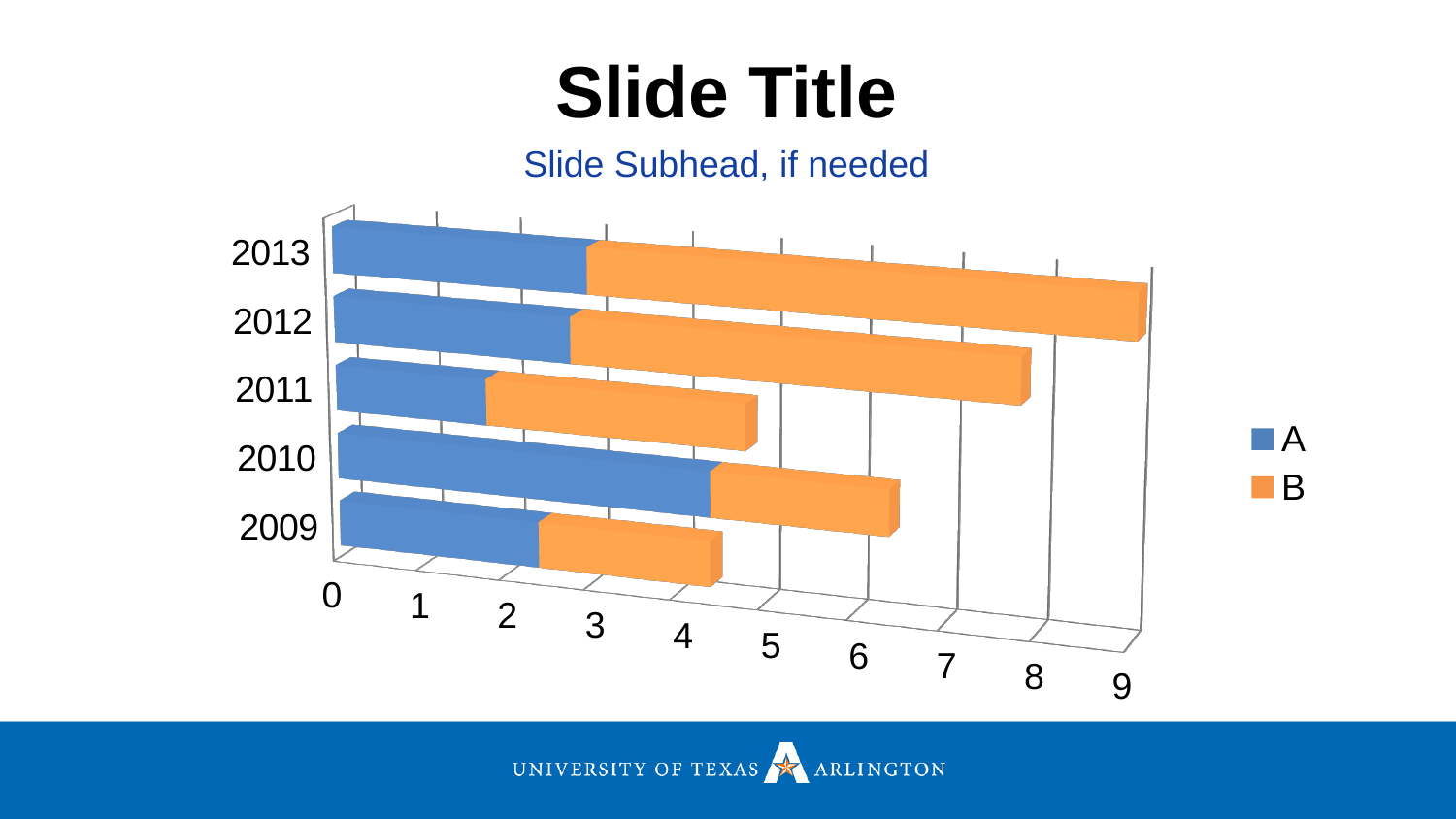
Is the total stacked bar for 2009 greater or less than 6? less How many series does the legend list? 2 Which colour represents series B? Orange Which year has the larger value for series A, 2010 or 2009? 2010 What kind of chart is shown on the slide? Stacked bar chart What are the names of the series in the legend? A and B Which year has the shortest total stacked bar? 2009 Which year has the larger total stacked bar, 2012 or 2011? 2012 How many categories (years) are shown on the chart? 5 Is the total stacked bar for 2013 greater or less than 5? greater Which year has the longest total stacked bar? 2013 Is the value of series A for 2010 greater or less than 2? greater